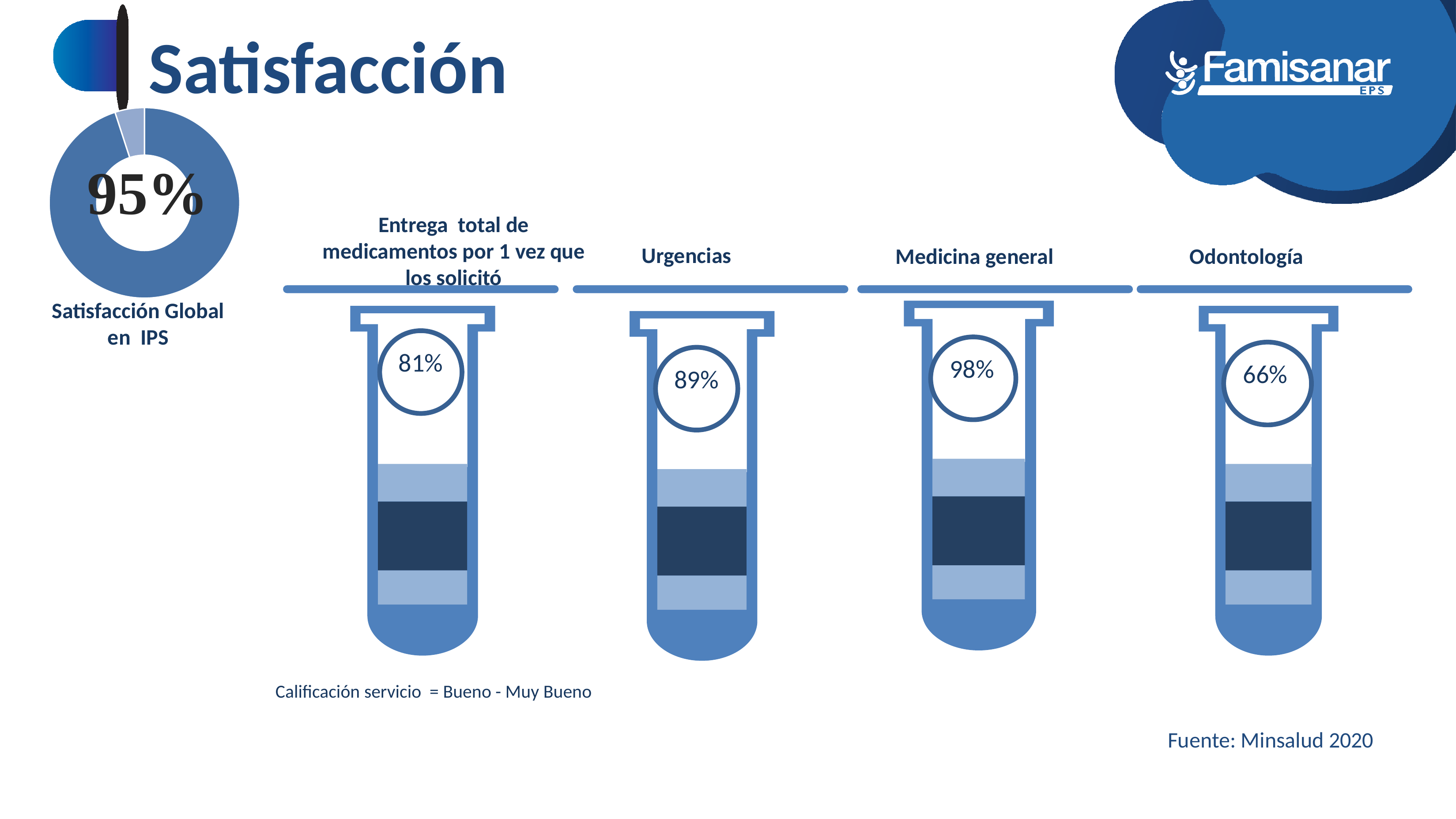
In the test-tube graphic, what is the satisfaction value for 'Medicina general'? 98% What kind of chart is used to show 'Satisfacción Global en IPS'? Donut (pie) chart In the test-tube graphic, what is the satisfaction value for 'Entrega total de medicamentos por 1 vez que los solicitó'? 81% In the test-tube graphic, what is the difference between the values for 'Medicina general' and 'Odontología'? 32% How many services are shown in the test-tube graphic? 4 In the test-tube graphic, what is the satisfaction value for 'Odontología'? 66% What percentage is shown in the centre of the donut chart labelled 'Satisfacción Global en IPS'? 95% In the test-tube graphic, what is the satisfaction value for 'Urgencias'? 89% In the test-tube graphic, which service has the lowest satisfaction value? Odontología In the test-tube graphic, which service has the highest satisfaction value? Medicina general In the donut chart, what share of the whole does the large dark blue slice represent? 95% In the donut chart, what share of the whole does the small light blue slice represent? 5%